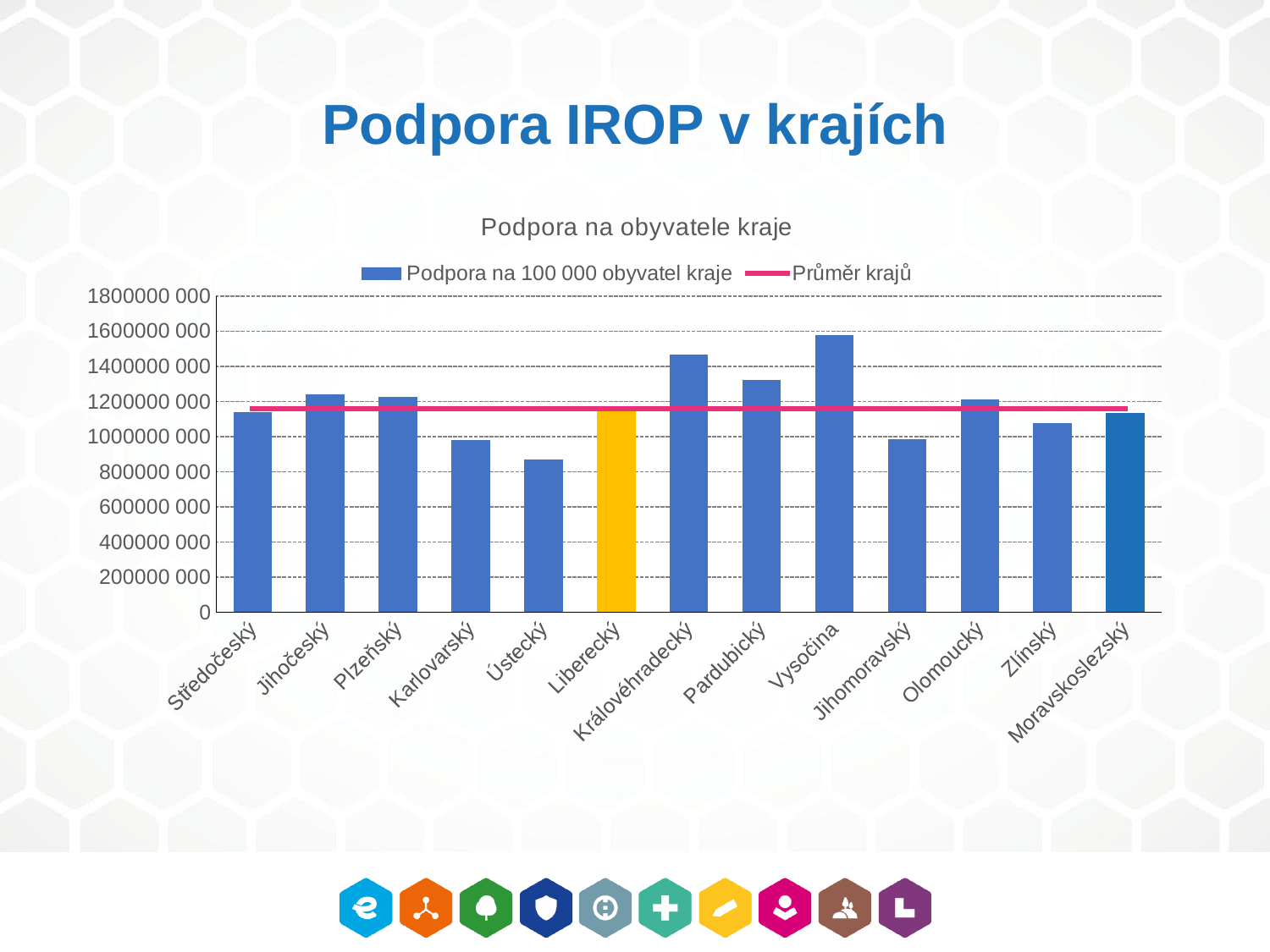
How many series does the legend list? 2 Is the value for Karlovarský greater or less than 1000000 000? less Which is larger, the value for Královéhradecký or the value for Pardubický? Královéhradecký How many regions (categories) are shown on the x axis? 13 What type of chart is shown on the slide? combination bar and line chart Is the value for Vysočina greater or less than 1400000 000? greater Is the value for Pardubický greater or less than 1200000 000? greater What is the title of the chart? Podpora na obyvatele kraje Which region's bar is highlighted in yellow instead of blue? Liberecký Which region has the highest value for Podpora na 100 000 obyvatel kraje? Vysočina Which region has the lowest value for Podpora na 100 000 obyvatel kraje? Ústecký